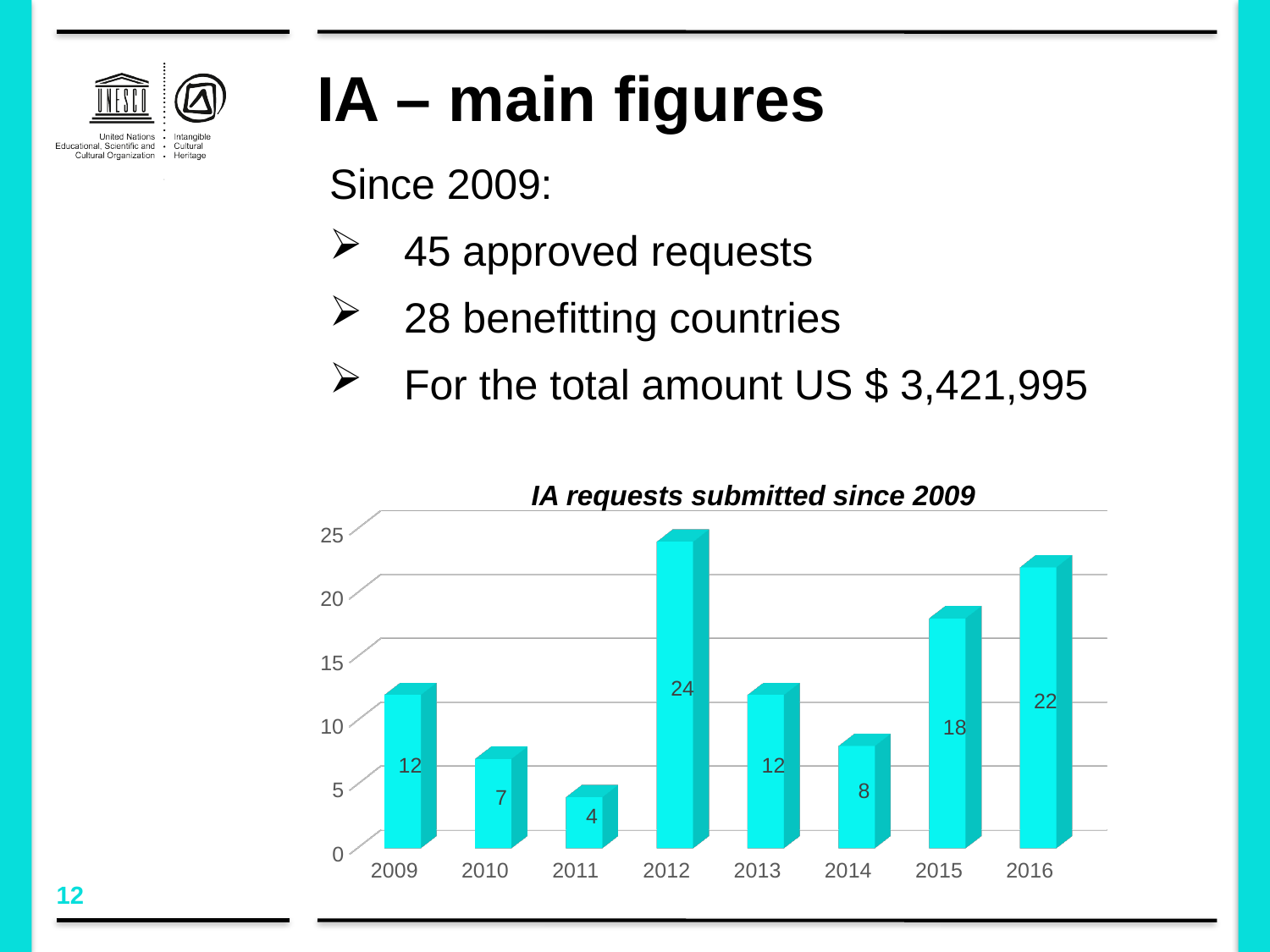
Which year has the lowest number of IA requests submitted? 2011 Which year has the highest number of IA requests submitted? 2012 How many years are shown on the x axis of the chart? 8 What is the title of the chart? IA requests submitted since 2009 What is the value for 2012 in the chart? 24 Is the value for 2015 greater or less than 15? greater Which is larger, the value for 2013 or the value for 2010? 2013 What is the value for 2015 in the chart? 18 What kind of chart is shown on the slide? bar chart What is the difference between the values for 2016 and 2014? 14 Do the values rise or fall from 2013 to 2016? fall then rise What is the value for 2010 in the chart? 7